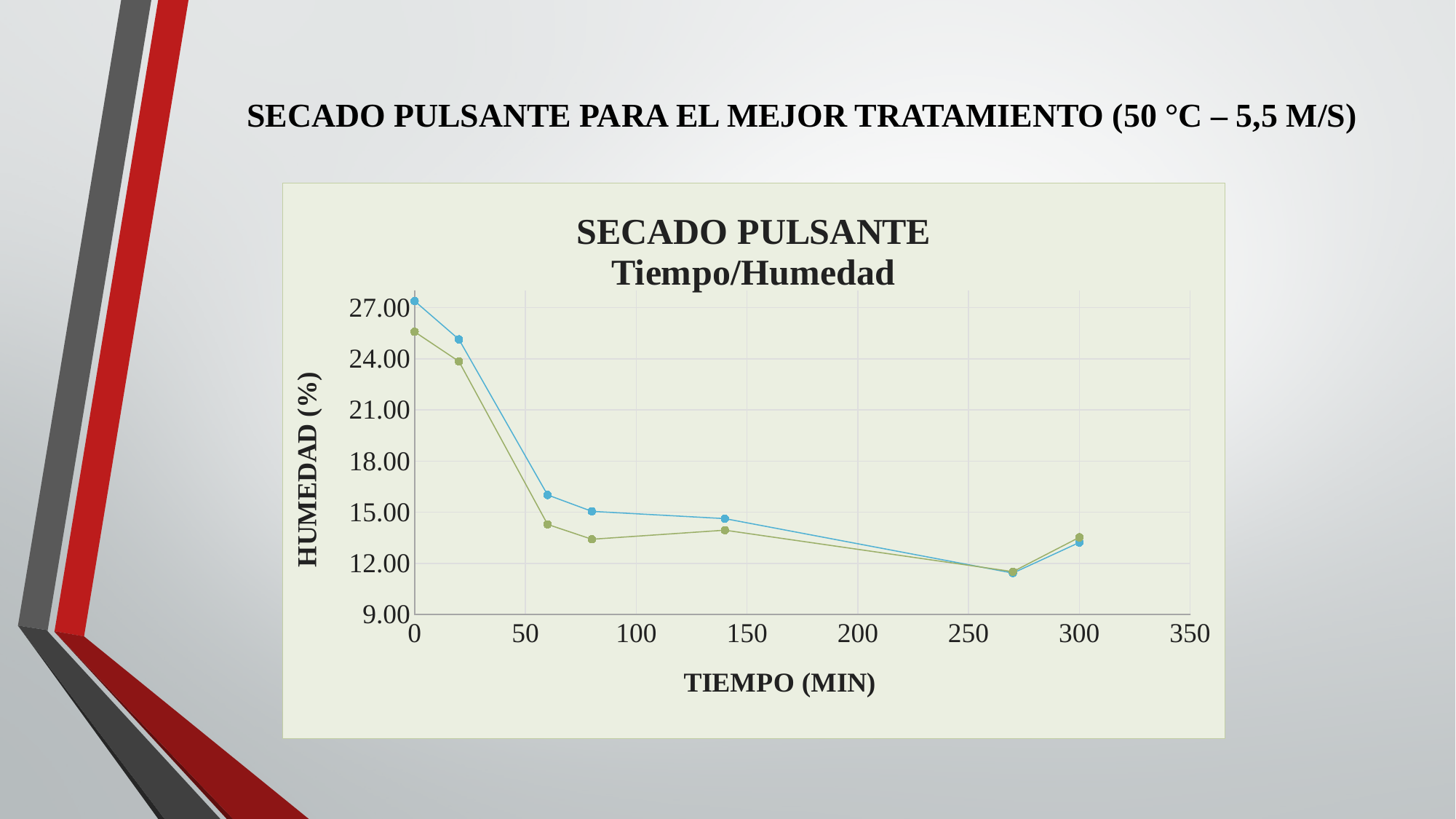
Is the value of the blue line at 60 minutes greater or less than 15.00? greater Is the value of the blue line at 270 minutes greater or less than 12.00? less How many lines (series) are plotted on the chart? 2 Is the value of the green line at 60 minutes greater or less than 15.00? less Do the humidity values generally rise or fall as time increases from 0 to 270 minutes? fall What kind of chart is shown on the slide? line chart How many data points does the blue line have? 7 At which time (min) does the green line reach its lowest value? 270 At 0 minutes, which line has the higher humidity value, the blue or the green? blue At which time (min) does the blue line reach its highest value? 0 What is the label of the y axis? HUMEDAD (%) What is the title of the chart? SECADO PULSANTE Tiempo/Humedad